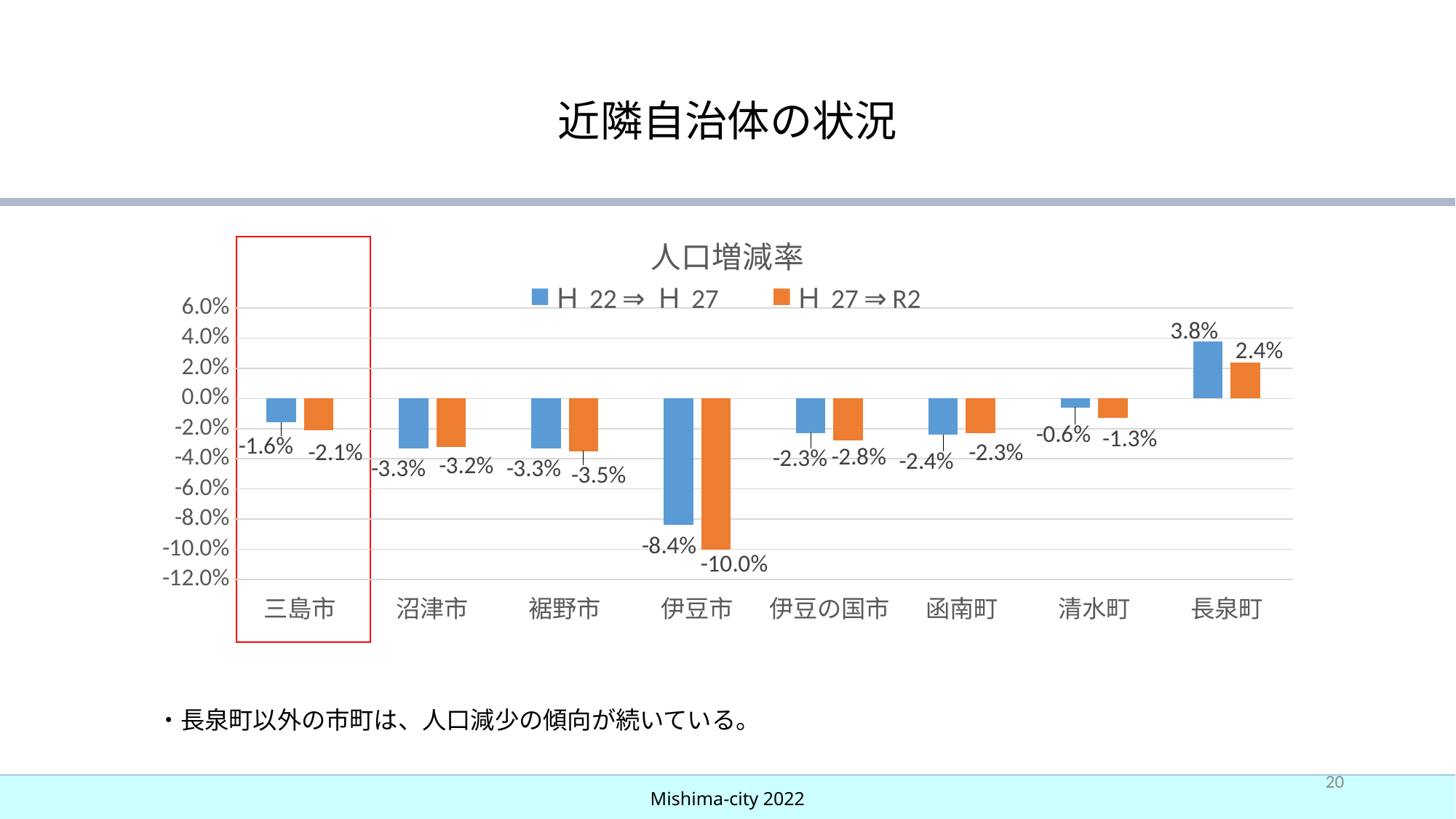
What is the value for 三島市 in the Ｈ22⇒Ｈ27 series? -1.6% What is the value for 長泉町 in the Ｈ22⇒Ｈ27 series? 3.8% What is the value for 伊豆市 in the Ｈ27⇒R2 series? -10.0% What kind of chart is shown on the slide? Bar chart How many municipalities are shown on the x axis? 8 Which category has the highest value in the Ｈ27⇒R2 series? 長泉町 Which category has the lowest value in the Ｈ22⇒Ｈ27 series? 伊豆市 Which category is highlighted with a red box? 三島市 What is the title of the chart? 人口増減率 What is the difference between the Ｈ22⇒Ｈ27 and Ｈ27⇒R2 values for 伊豆市? 1.6% How many series does the legend list? 2 Which is larger for 清水町: the Ｈ22⇒Ｈ27 value or the Ｈ27⇒R2 value? Ｈ22⇒Ｈ27